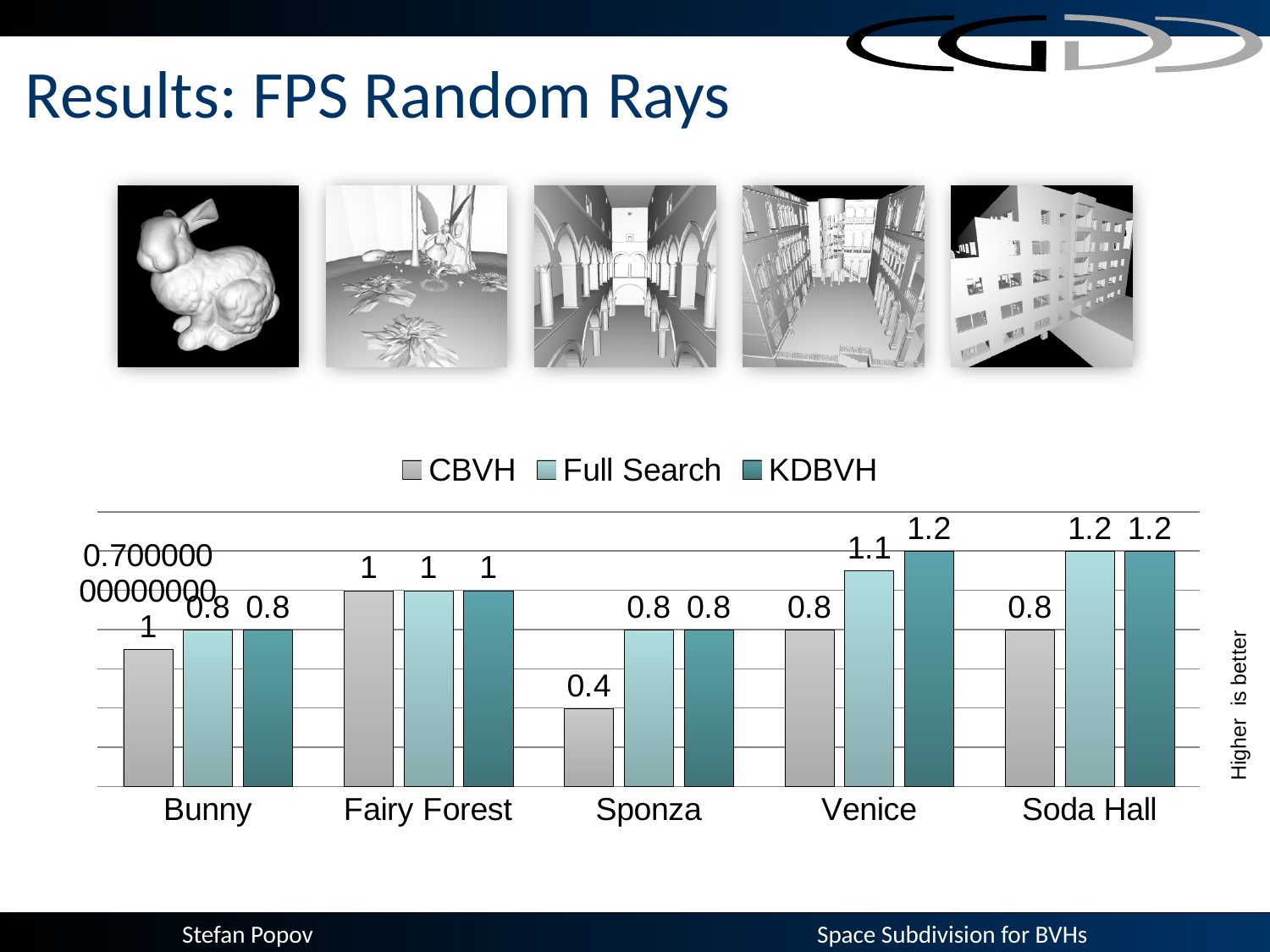
How many scenes are shown on the x axis of the chart? 5 What is the KDBVH value for Soda Hall? 1.2 For Venice, which series has the highest value? KDBVH What is the Full Search value for Venice? 1.1 What is the KDBVH value for Fairy Forest? 1 Which scene has the lowest CBVH value? Sponza Which is larger: the Full Search value for Venice or the Full Search value for Soda Hall? Soda Hall How many series does the legend list? 3 What is the difference between the KDBVH and CBVH values for Venice? 0.4 What is the CBVH value for Sponza? 0.4 What kind of chart is shown on the slide? Bar chart What is the difference between the Full Search and CBVH values for Sponza? 0.4